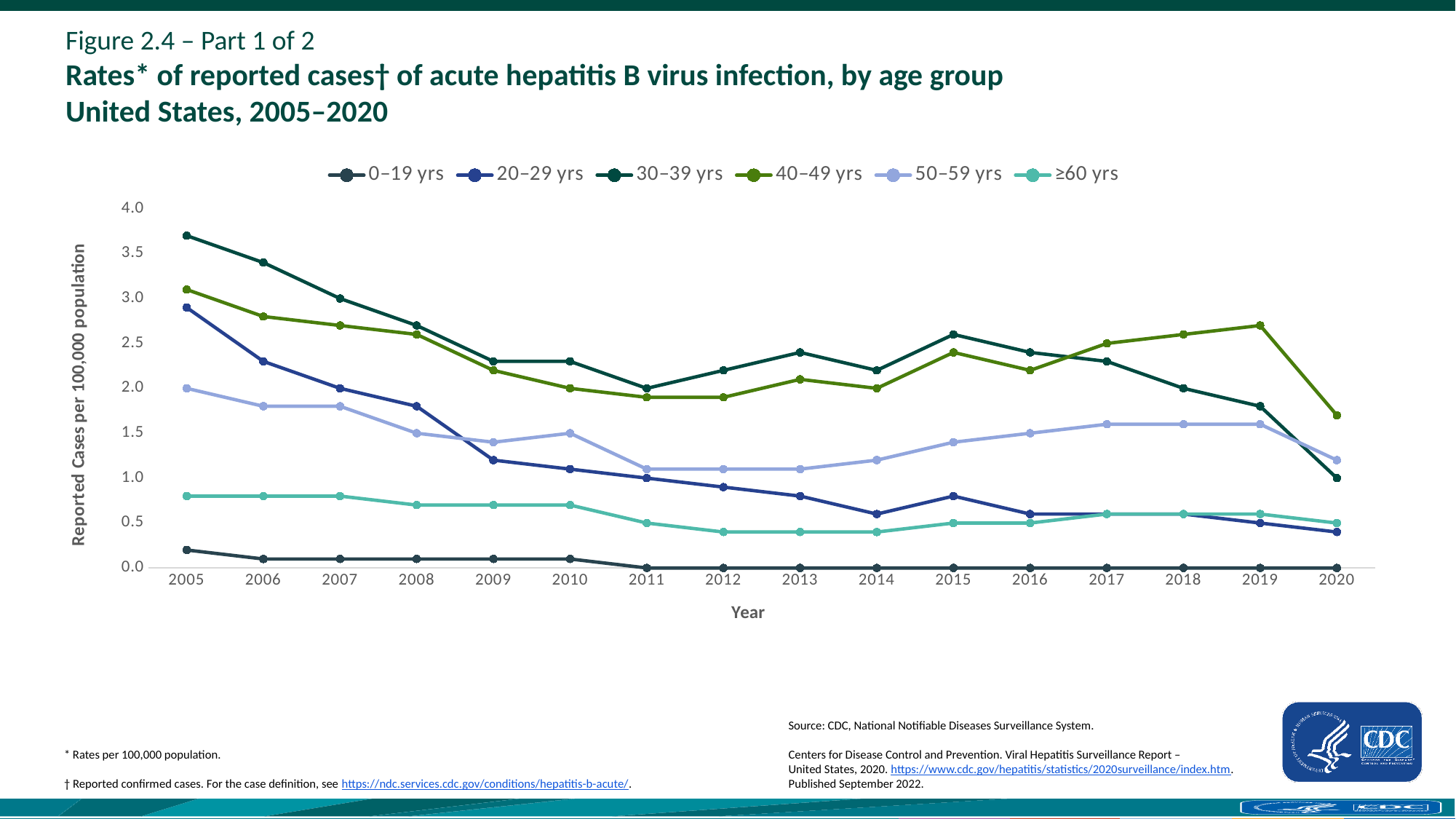
Is the rate for 20–29 yrs in 2020 greater or less than 0.5? less Is the rate for 30–39 yrs in 2005 greater or less than 3.5? greater What is the rate for 0–19 yrs in 2015? 0.0 Does the rate for 30–39 yrs rise or fall overall from 2005 to 2020? fall In 2019, which age group had the higher rate: 40–49 yrs or 30–39 yrs? 40–49 yrs How many age groups does the legend list? 6 Which age group had the highest rate in 2005? 30–39 yrs What kind of chart is shown on the slide? line chart Which age group had the highest rate in 2020? 40–49 yrs Is the rate for 40–49 yrs in 2019 greater or less than 2.5? greater How many years are plotted along the x axis? 16 Which age group had the lowest rate in 2005? 0–19 yrs